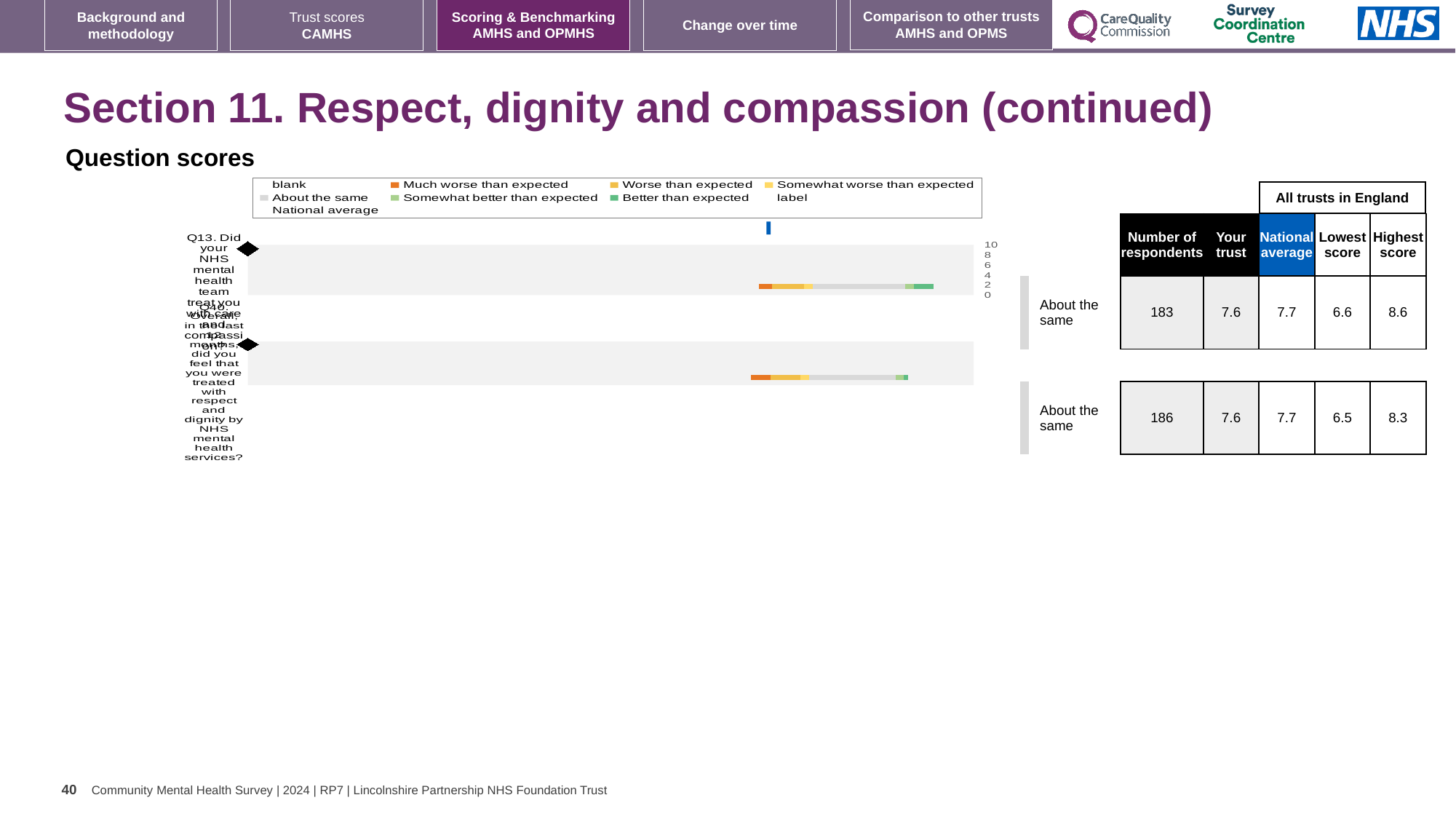
What is the difference between the highest and lowest scores for Q13? 2.0 What is the lowest score among all trusts in England for Q13? 6.6 What kind of chart is shown on the slide? bar chart How many respondents answered Q10? 186 How many questions (bars) are plotted in the chart? 2 Which question had more respondents, Q13 or Q10? Q10 What is the 'Your trust' score for Q13? 7.6 What is the highest score among all trusts in England for Q10? 8.3 Which question has the higher 'Highest score' value, Q13 or Q10? Q13 How many entries does the chart legend list? 9 What benchmark category is shown next to both Q13 and Q10? About the same What is the national average score for Q10? 7.7